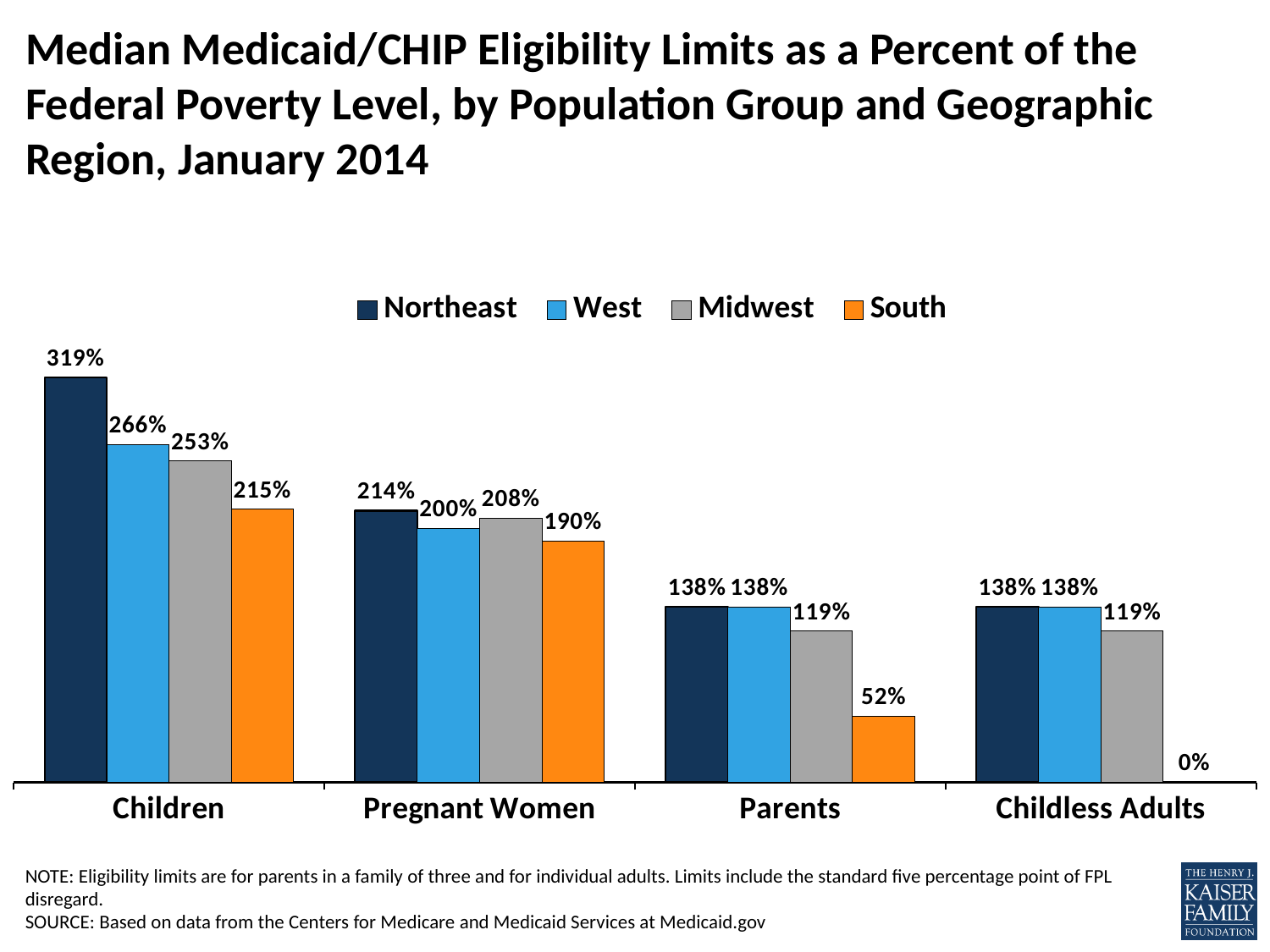
What is the value for Pregnant Women in the Midwest? 208% What is the difference between the Northeast and South values for Children? 104% What kind of chart is shown on the slide? Bar chart How many population groups are shown on the x axis? 4 What is the value for Parents in the South? 52% Which region has the lowest eligibility limit for Pregnant Women? South What is the median Medicaid/CHIP eligibility limit for Children in the Northeast? 319% What is the difference between the West and Midwest values for Parents? 19% Which region has the highest eligibility limit for Children? Northeast Which is larger for Pregnant Women: the West value or the Midwest value? Midwest What is the value for Childless Adults in the South? 0% How many series does the legend list? 4